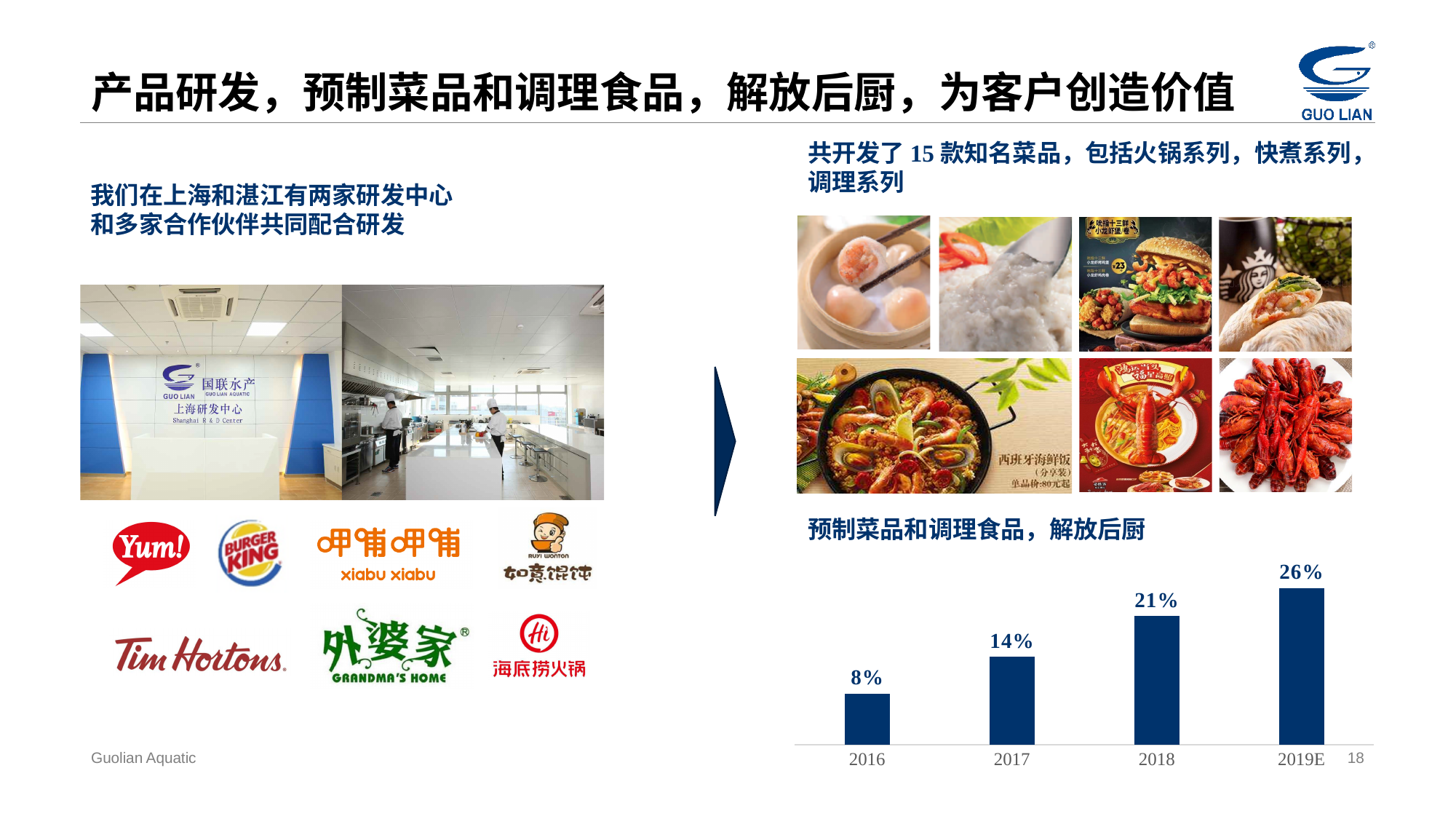
Which year has the lowest value in the bar chart? 2016 Do the values in the bar chart rise or fall from 2016 to 2019E? Rise What is the value for 2019E in the bar chart? 26% What is the value for 2017 in the bar chart? 14% What is the value for 2016 in the bar chart? 8% Which year has the highest value in the bar chart? 2019E What is the difference between the values for 2018 and 2017? 7% Which is larger, the value for 2017 or the value for 2018? 2018 What kind of chart is shown at the bottom right of the slide? Bar chart What is the value for 2018 in the bar chart? 21% What is the difference between the values for 2019E and 2016? 18% How many bars are shown in the bar chart? 4